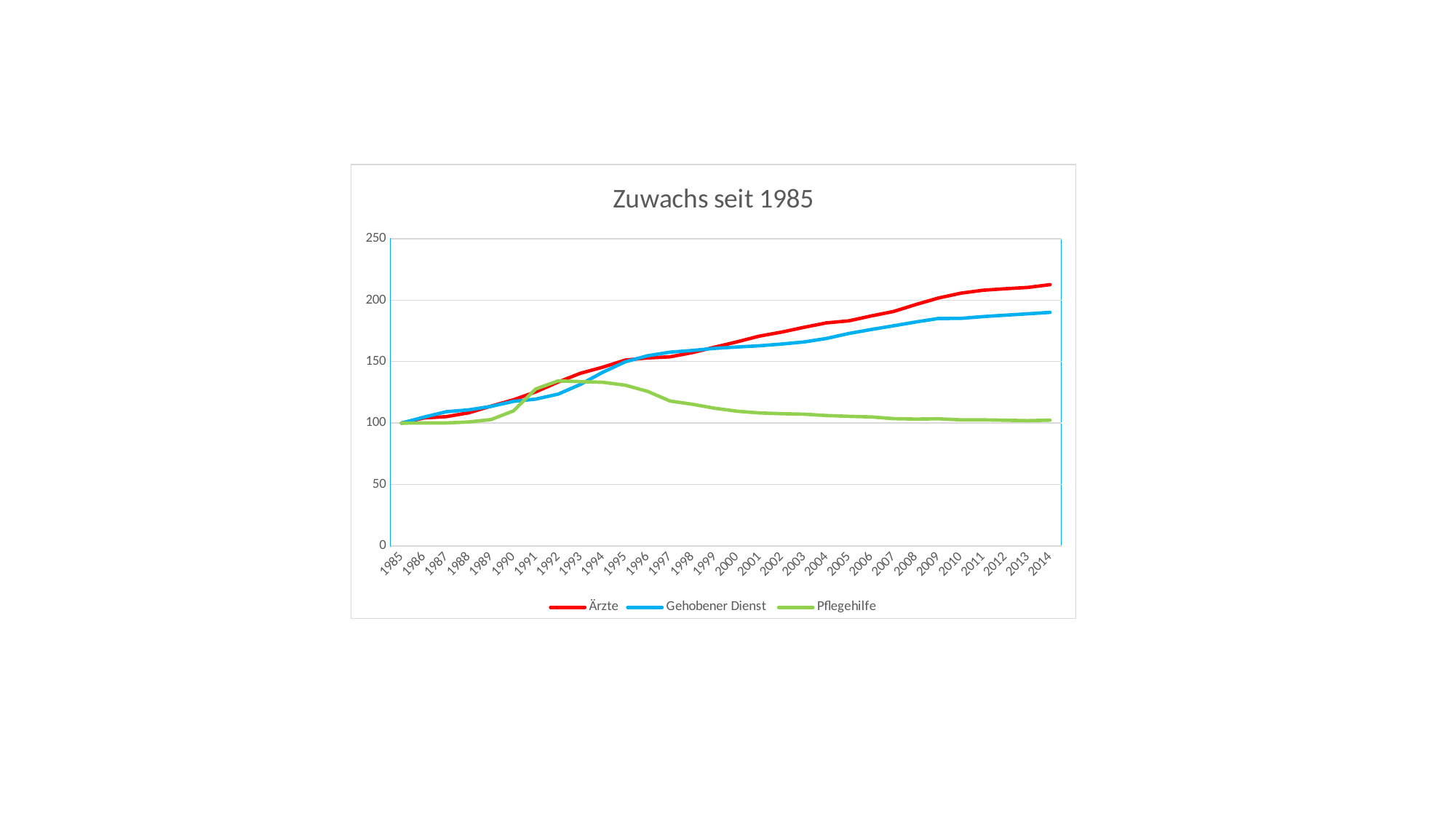
Is the value for Gehobener Dienst in 2014 greater or less than 200? less What is the value for Ärzte in 1985? 100 Is the value for Pflegehilfe in 2014 greater or less than 150? less How many years are shown on the x axis? 30 Which colour is used for the Pflegehilfe series? Green Which series has the lowest value in 2014? Pflegehilfe Does the Ärzte series rise or fall from 1985 to 2014? Rise What is the title of the chart? Zuwachs seit 1985 What kind of chart is shown on the slide? Line chart How many series does the legend list? 3 Is the value for Ärzte in 2014 greater or less than 200? greater Which series has the highest value in 2014? Ärzte